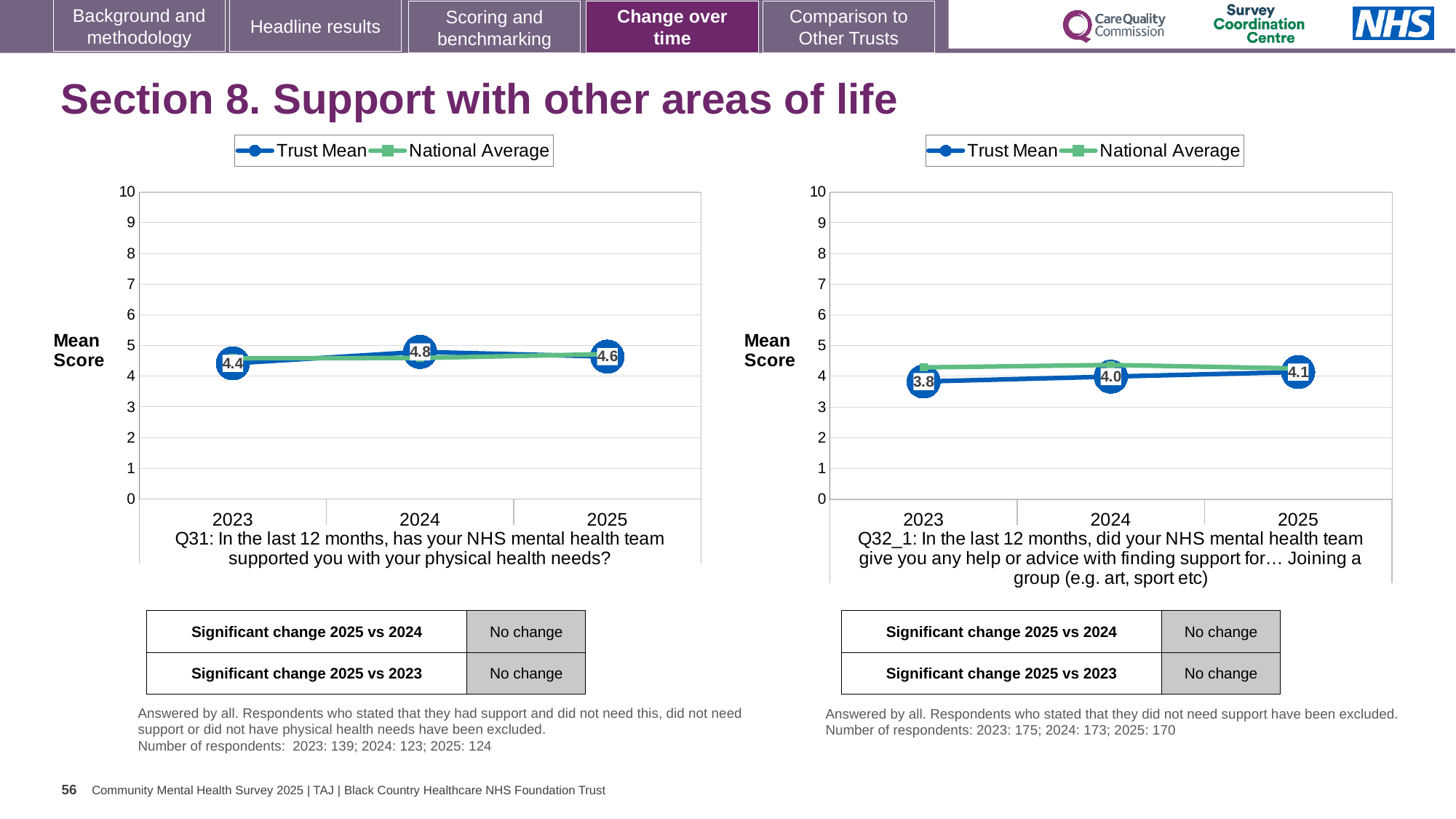
On the right chart (Q32_1), which year has the lowest Trust Mean score? 2023 On the left chart (Q31), which year has the highest Trust Mean score? 2024 On the left chart (Q31), what is the difference between the Trust Mean scores for 2024 and 2023? 0.4 On the right chart (Q32_1), what is the Trust Mean score for 2023? 3.8 What kind of chart is the left chart (Q31)? Line chart On the right chart (Q32_1), what is the difference between the Trust Mean scores for 2025 and 2023? 0.3 On the left chart (Q31), what is the Trust Mean score for 2023? 4.4 On the left chart (Q31), is the Trust Mean score for 2025 greater or less than 5? less On the left chart (Q31), what is the Trust Mean score for 2024? 4.8 How many series does the legend of the right chart (Q32_1) list? 2 On the right chart (Q32_1), does the Trust Mean score rise or fall from 2023 to 2025? Rise On the right chart (Q32_1), what is the Trust Mean score for 2025? 4.1